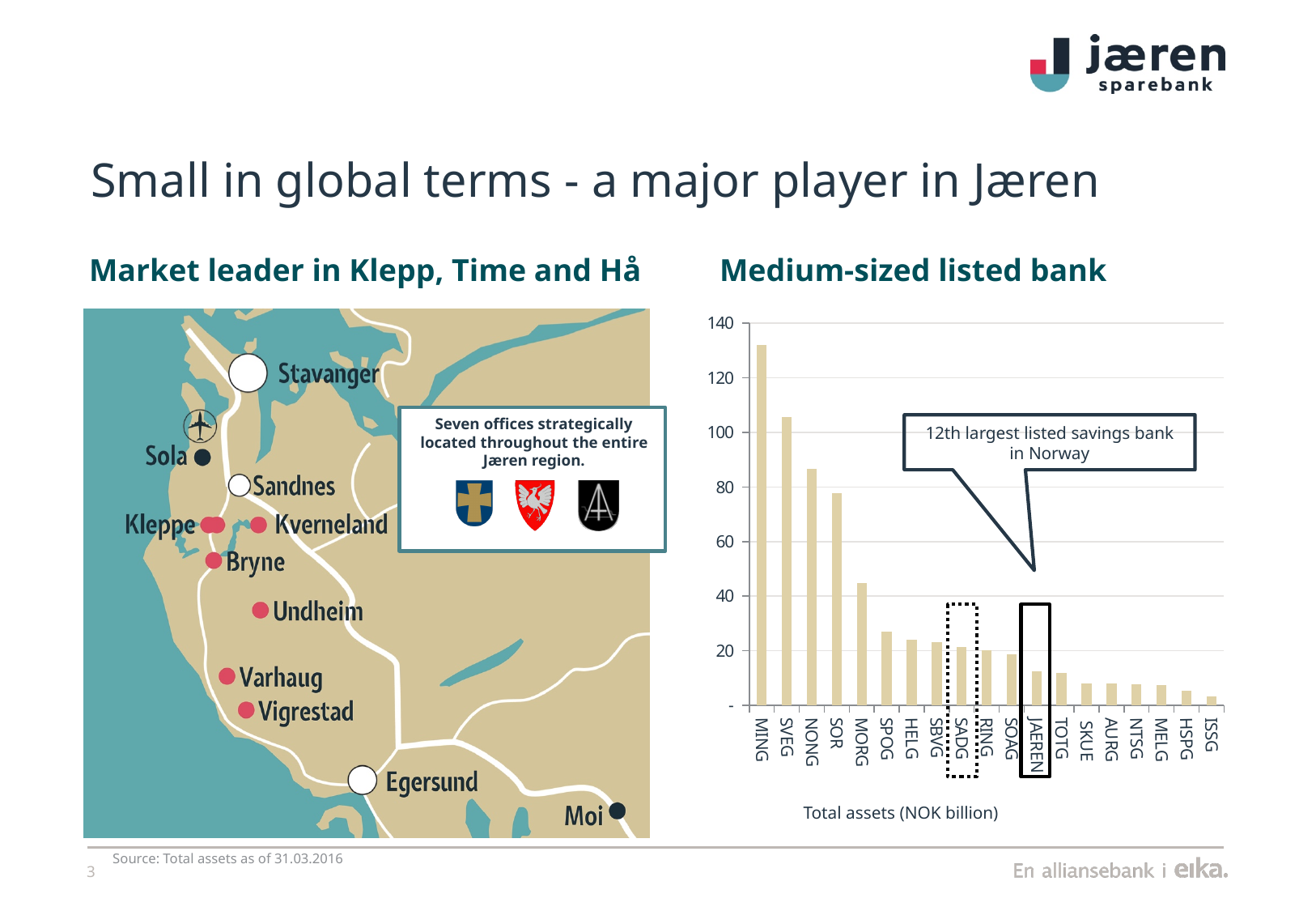
Which bank has the highest total assets in the bar chart? MING Is the value for MING greater or less than 120? greater Which bank has the lowest total assets in the bar chart? ISSG Do the bar values rise or fall moving from left to right along the x axis? fall What kind of chart is shown under the heading "Medium-sized listed bank"? bar chart Is the value for MORG greater or less than 40? greater Is the value for SVEG greater or less than 100? greater Which has larger total assets, JAEREN or SOR? SOR What does the label below the bar chart say the bars measure? Total assets (NOK billion) Which has larger total assets, NONG or MORG? NONG How many banks are plotted in the bar chart? 19